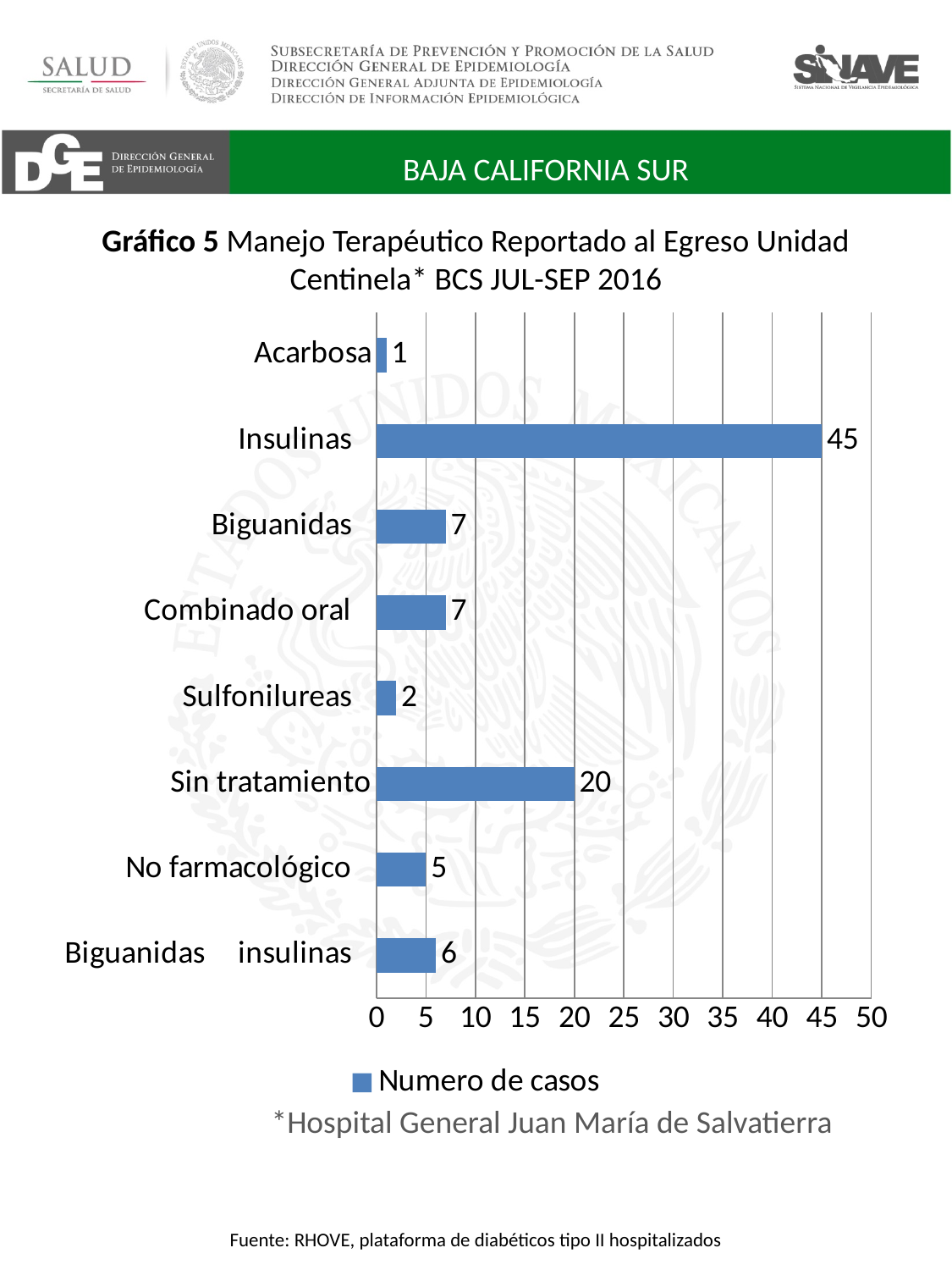
What kind of chart is shown? Bar chart Which has more cases, Biguanidas insulinas or No farmacológico? Biguanidas insulinas How many categories are shown in the chart? 8 What is the number of cases for No farmacológico? 5 What is the number of cases for Insulinas? 45 How many series does the legend list? 1 Which category has the lowest number of cases? Acarbosa Which category has the highest number of cases? Insulinas What is the legend entry for the series? Numero de casos What is the number of cases for Sin tratamiento? 20 What is the difference in number of cases between Insulinas and Sin tratamiento? 25 What is the difference in number of cases between Biguanidas and Sulfonilureas? 5